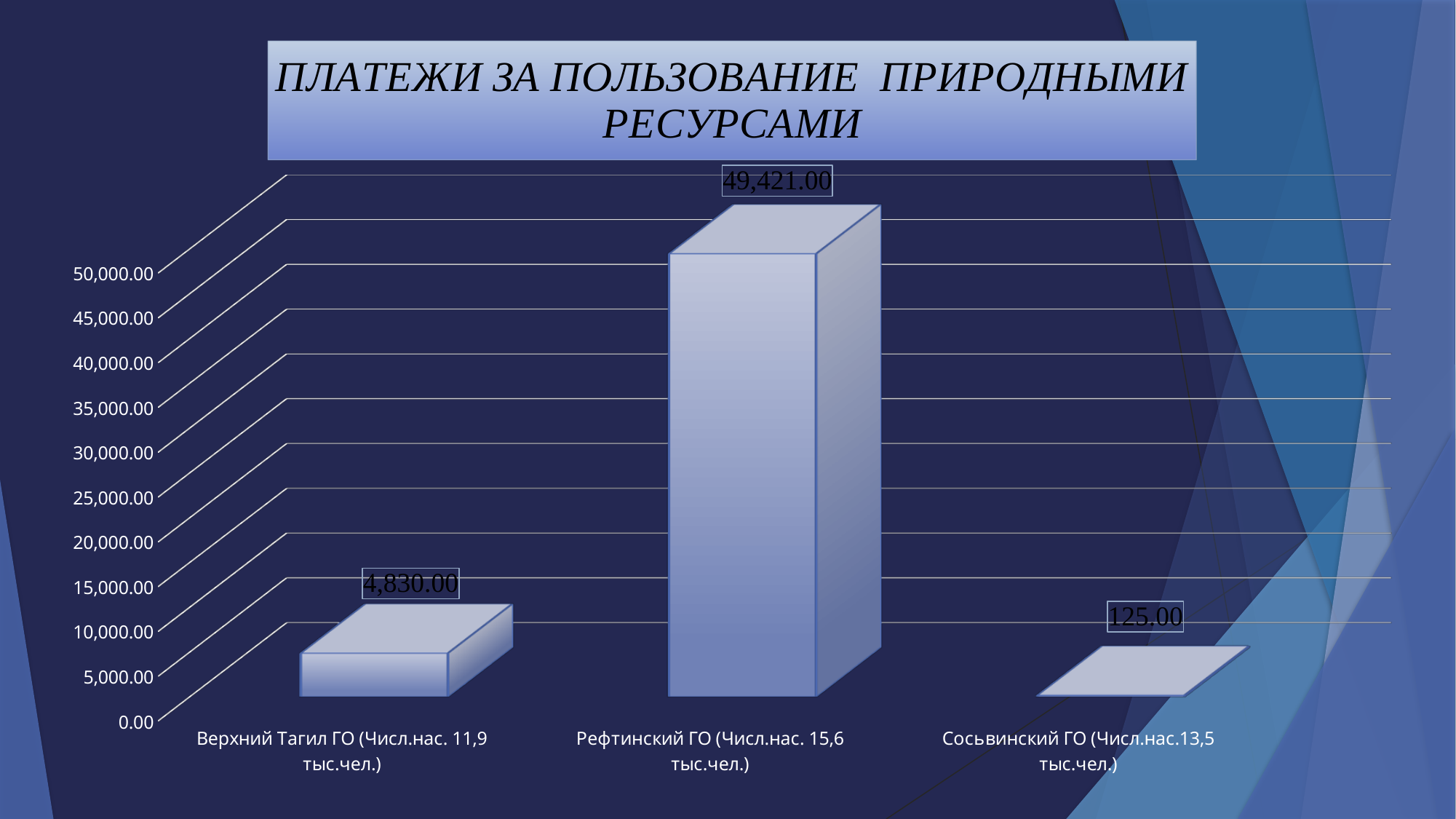
What is the difference between the values for Верхний Тагил ГО and Сосьвинский ГО? 4,705.00 What is the value for Верхний Тагил ГО? 4,830.00 Which category has the highest value? Рефтинский ГО Which category has the lowest value? Сосьвинский ГО Is the value for Рефтинский ГО greater or less than 45,000.00? greater What kind of chart is shown on the slide? bar chart How many categories are shown in the chart? 3 What is the value for Сосьвинский ГО? 125.00 What is the title of the chart? ПЛАТЕЖИ ЗА ПОЛЬЗОВАНИЕ ПРИРОДНЫМИ РЕСУРСАМИ Which is larger, the value for Верхний Тагил ГО or Сосьвинский ГО? Верхний Тагил ГО What is the difference between the values for Рефтинский ГО and Верхний Тагил ГО? 44,591.00 What is the value for Рефтинский ГО? 49,421.00